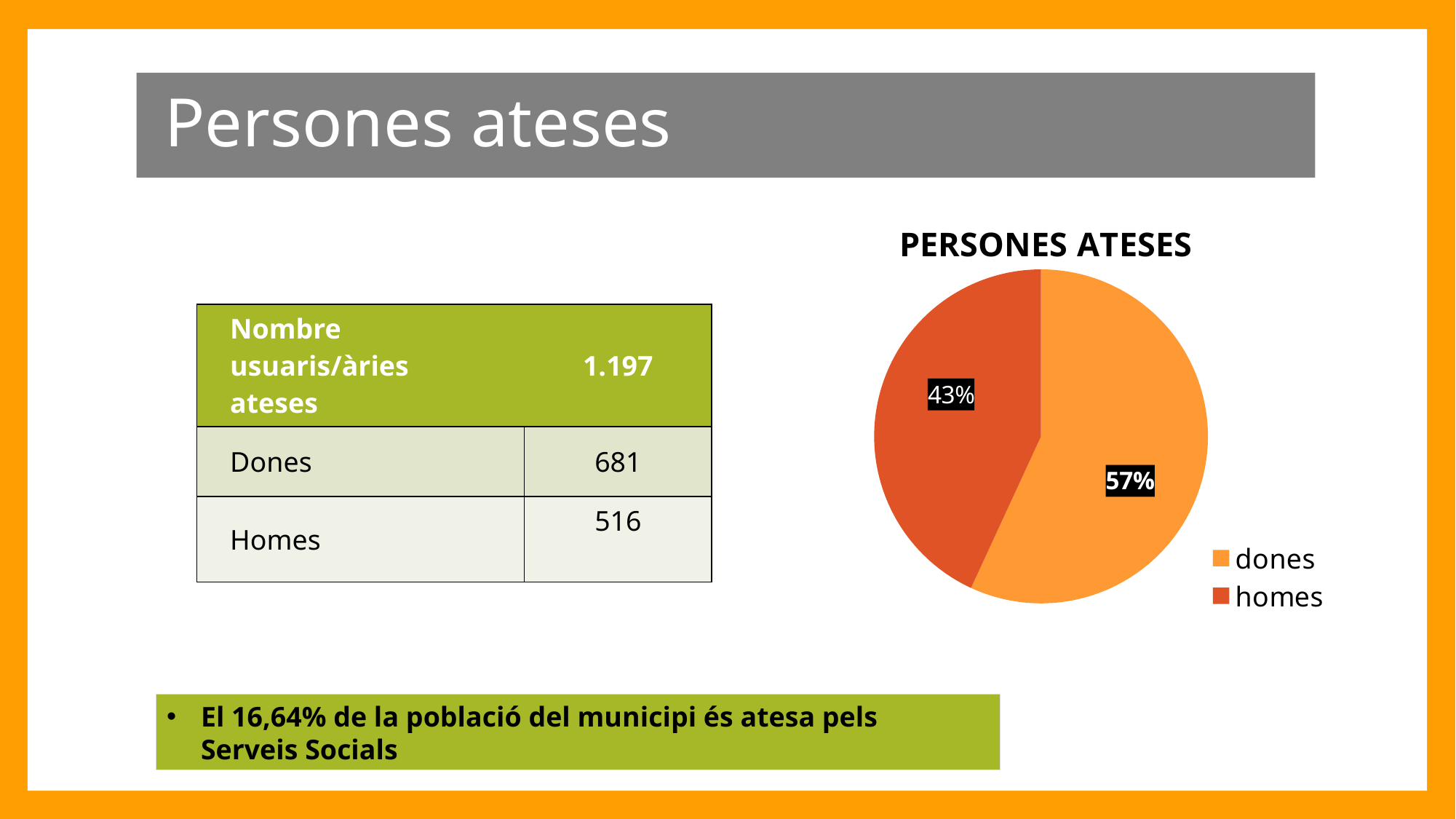
Which is larger, the 'dones' slice or the 'homes' slice? dones What kind of chart is shown on the slide? pie chart What percentage of the pie does the 'homes' slice represent? 43% How many entries does the legend list? 2 What is the difference in percentage points between the 'dones' and 'homes' slices? 14 What is the title of the chart? PERSONES ATESES Which slice of the pie is the largest? dones How many slices does the pie chart have? 2 Which colour represents 'homes' in the pie chart? red-orange What percentage of the pie does the 'dones' slice represent? 57% Which slice of the pie is the smallest? homes